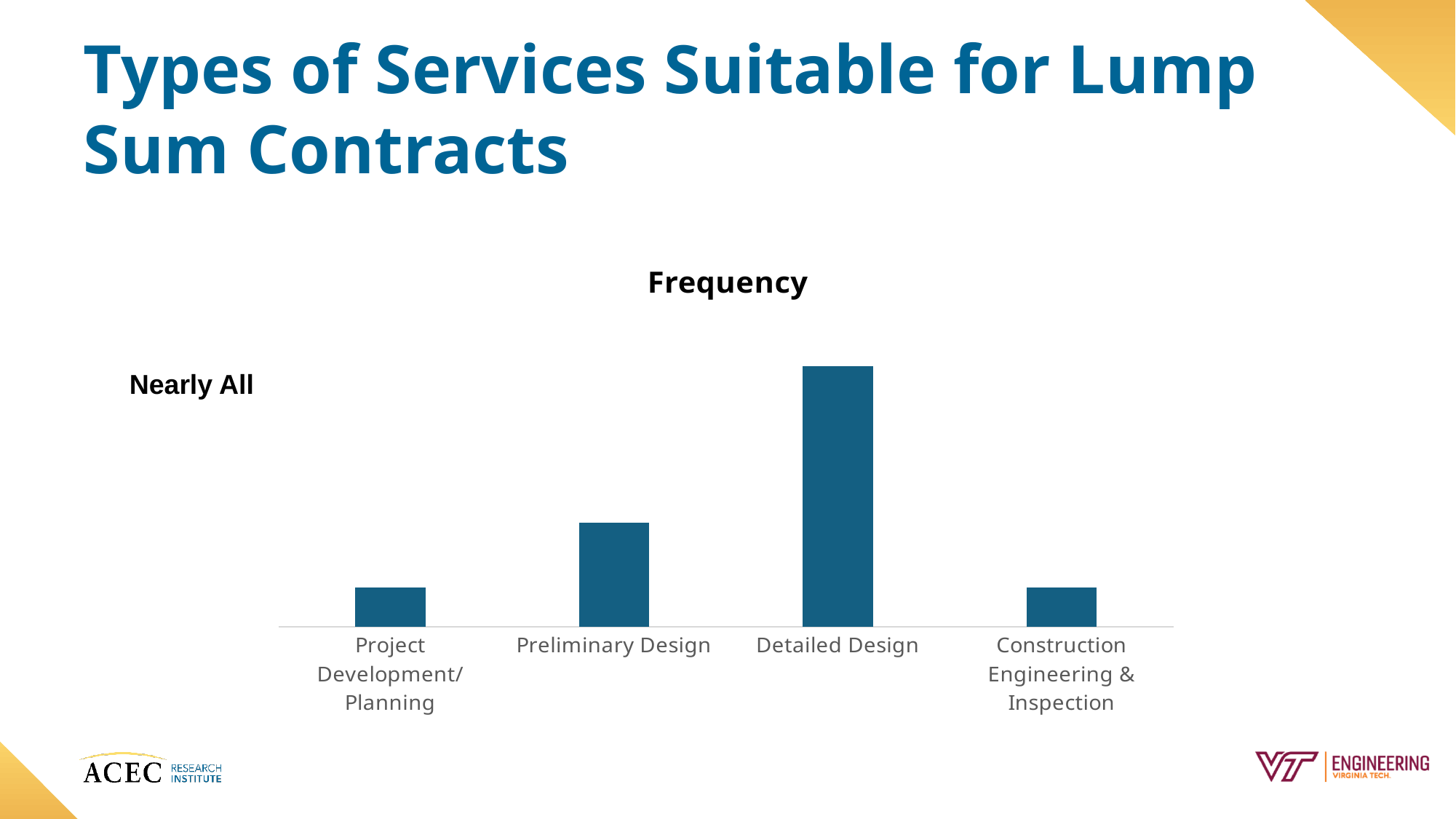
Which is larger, the bar for Construction Engineering & Inspection or the bar for Detailed Design? Detailed Design Which category has the second-highest bar in the chart? Preliminary Design What is the title of the chart? Frequency Which category has the highest bar in the chart? Detailed Design Which is larger, the bar for Preliminary Design or the bar for Construction Engineering & Inspection? Preliminary Design Which is larger, the bar for Project Development/Planning or the bar for Preliminary Design? Preliminary Design How many categories are shown on the x axis of the chart? 4 What label is shown on the y axis of the chart? Nearly All What type of chart is shown on the slide? Bar chart